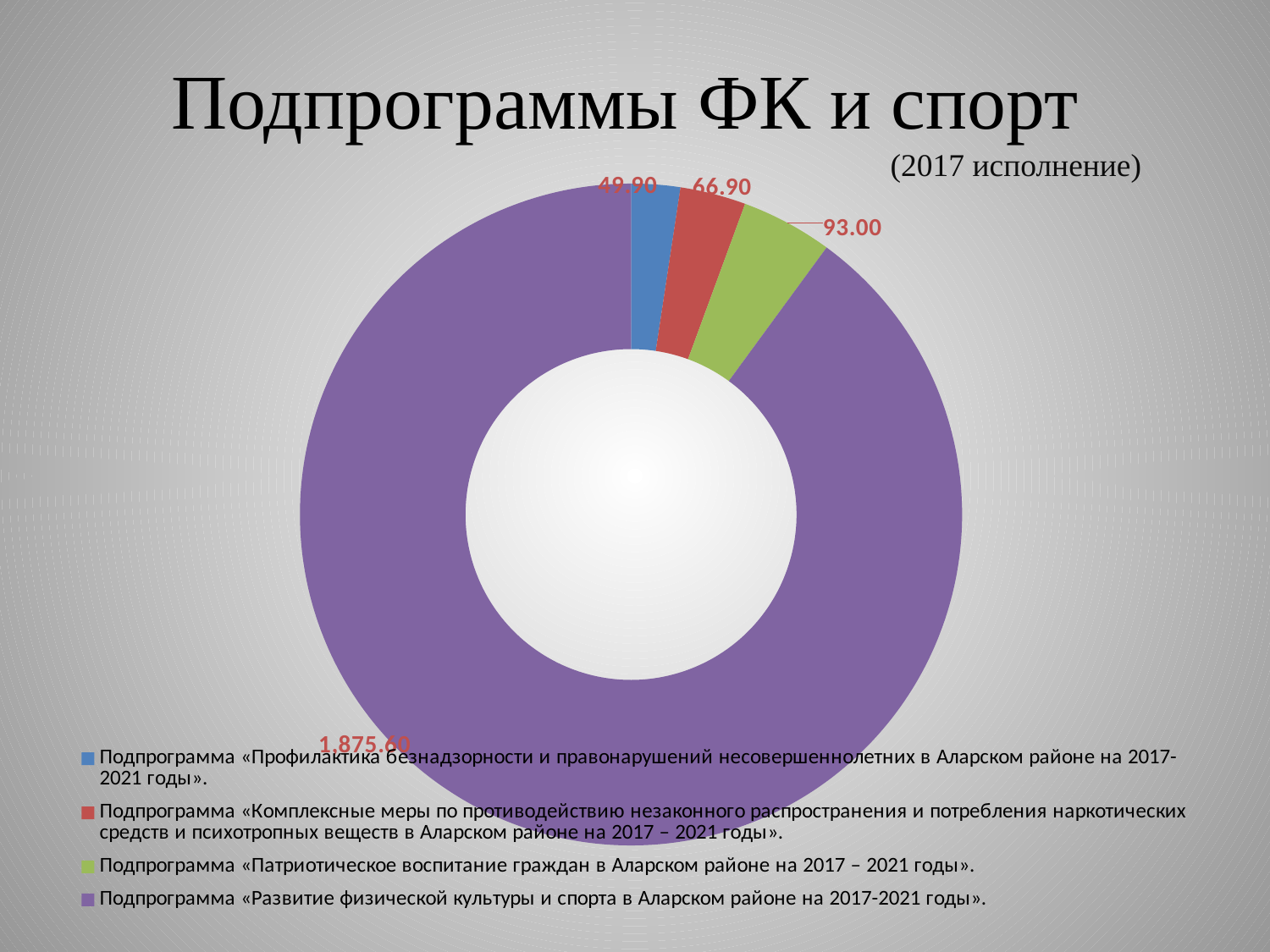
What is the difference between the values for «Патриотическое воспитание граждан» and «Комплексные меры по противодействию незаконного распространения и потребления наркотических средств»? 26.10 Which subprogram has the smallest value? Подпрограмма «Профилактика безнадзорности и правонарушений несовершеннолетних в Аларском районе на 2017-2021 годы» What is the value for the subprogram «Патриотическое воспитание граждан в Аларском районе на 2017 – 2021 годы»? 93.00 Which is larger: the value for «Комплексные меры по противодействию незаконного распространения и потребления наркотических средств» or the value for «Профилактика безнадзорности и правонарушений несовершеннолетних»? Комплексные меры по противодействию незаконного распространения и потребления наркотических средств What type of chart is shown on the slide? Doughnut chart What is the title of the slide containing the chart? Подпрограммы ФК и спорт How many slices does the chart have? 4 What is the value for the subprogram «Развитие физической культуры и спорта в Аларском районе на 2017-2021 годы»? 1,875.60 What is the value for the subprogram «Профилактика безнадзорности и правонарушений несовершеннолетних в Аларском районе на 2017-2021 годы»? 49.90 What is the value for the subprogram «Комплексные меры по противодействию незаконного распространения и потребления наркотических средств и психотропных веществ в Аларском районе на 2017 – 2021 годы»? 66.90 Which subprogram has the largest value? Подпрограмма «Развитие физической культуры и спорта в Аларском районе на 2017-2021 годы» What colour is the slice for «Патриотическое воспитание граждан в Аларском районе на 2017 – 2021 годы»? Green